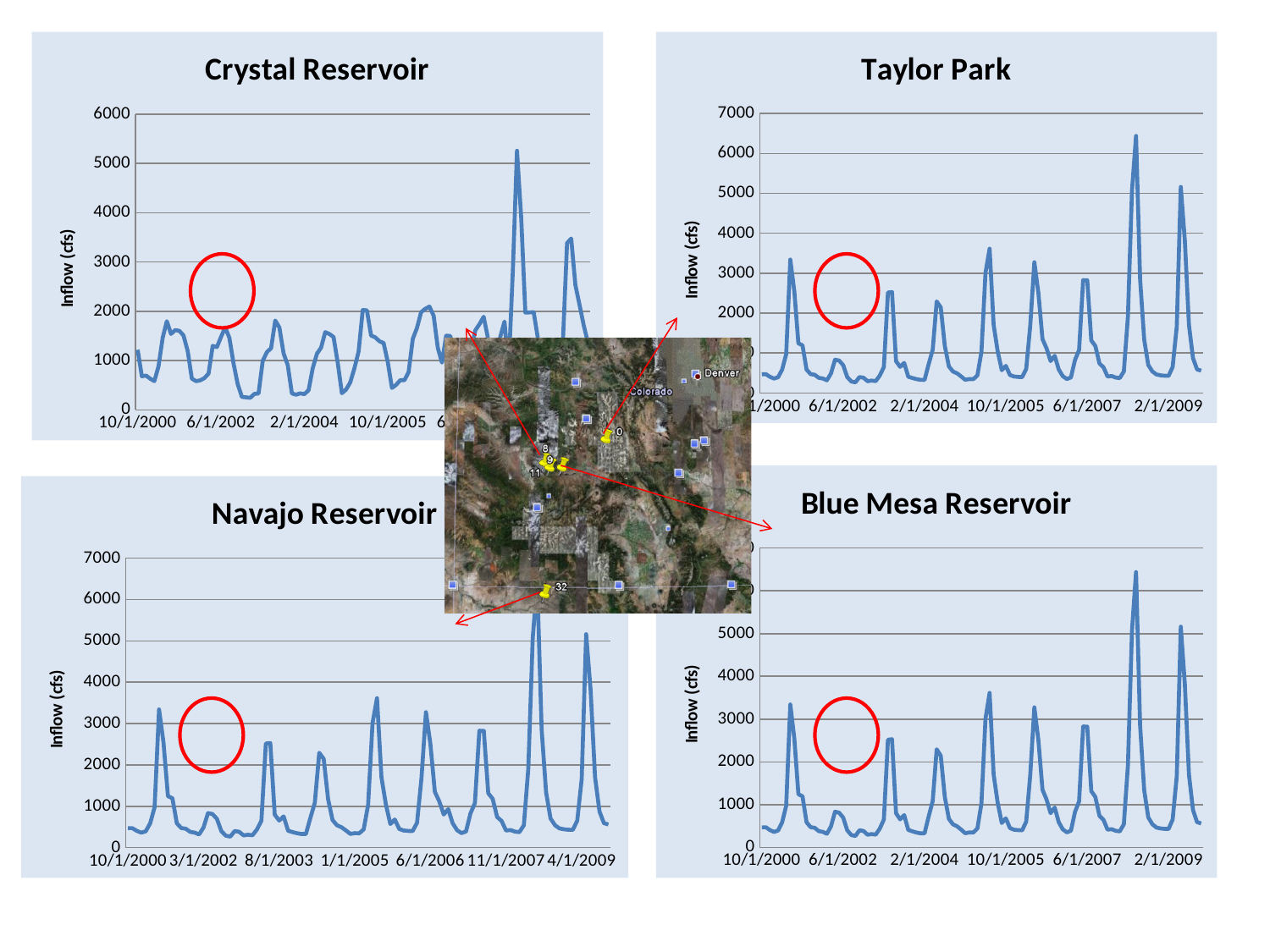
Which chart has the higher maximum peak inflow, Taylor Park or Crystal Reservoir? Taylor Park On the Navajo Reservoir chart, is the highest peak greater or less than 5000? greater On the Blue Mesa Reservoir chart, is the small peak near 6/1/2002 greater or less than 1000? less How many inflow charts are shown on the slide? 4 On the Crystal Reservoir chart, is the first peak after 10/1/2000 greater or less than 2000? less What is the y-axis label on the Taylor Park chart? Inflow (cfs) What kind of chart is the Crystal Reservoir chart? line chart